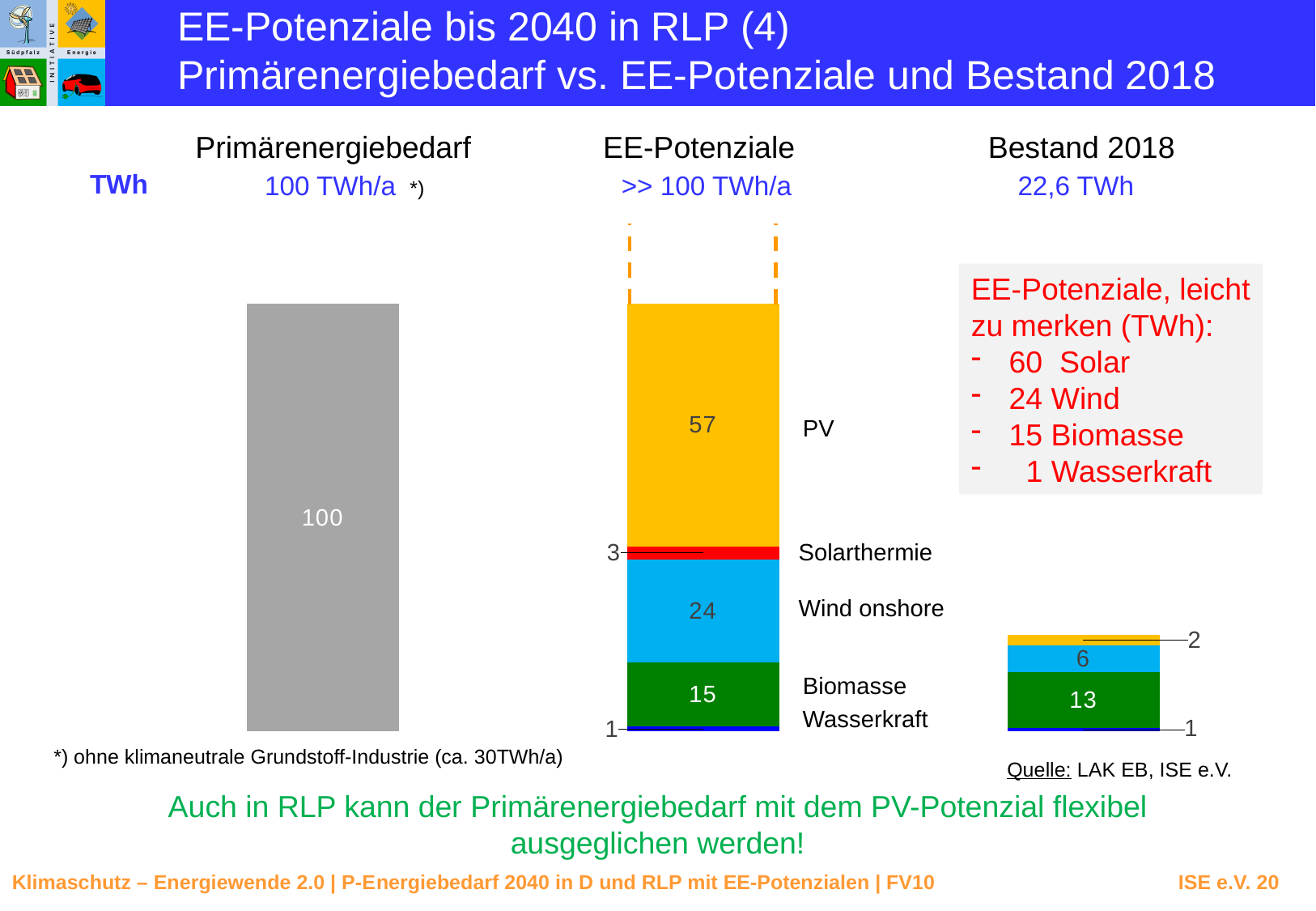
What is the value shown in the Primärenergiebedarf bar? 100 In the EE-Potenziale chart, what is the value of the Biomasse segment? 15 In the Bestand 2018 chart, what is the value of the green Biomasse segment? 13 In the EE-Potenziale chart, what is the difference between the PV and Wind onshore segments? 33 In the EE-Potenziale chart, which segment is the smallest? Wasserkraft In the EE-Potenziale chart, what is the value of the PV segment? 57 In the EE-Potenziale chart, which segment is the largest? PV In the EE-Potenziale chart, what is the value of the Solarthermie segment? 3 Which is larger: the Biomasse segment in the EE-Potenziale chart or the Biomasse segment in the Bestand 2018 chart? EE-Potenziale In the Bestand 2018 chart, what is the value of the light blue wind segment? 6 In the EE-Potenziale chart, what is the total of the stacked bar? 100 In the EE-Potenziale chart, what is the value of the Wind onshore segment? 24